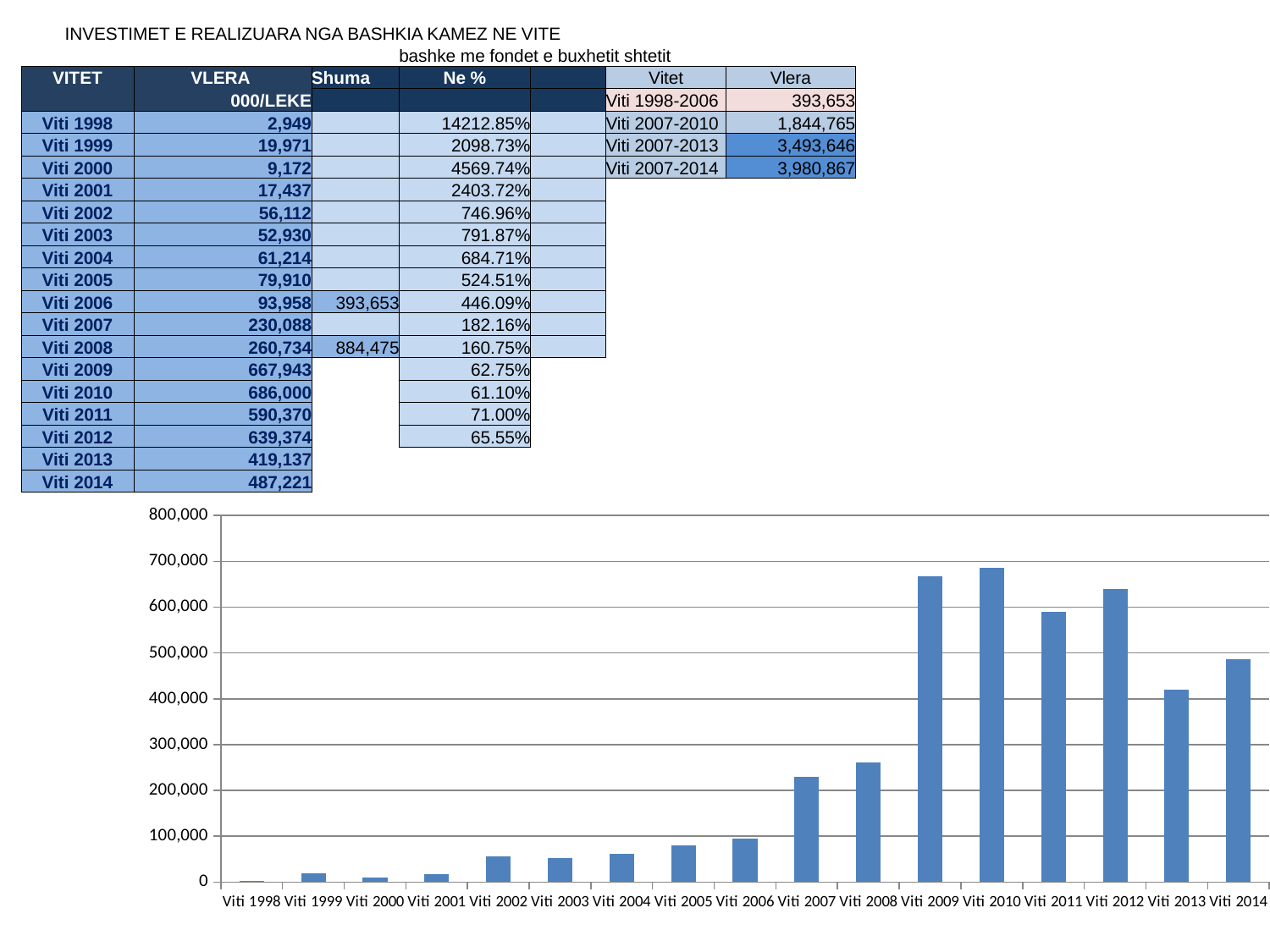
According to the table, what is the value (VLERA, 000/LEKE) for Viti 2010? 686,000 Is the value for Viti 2007 greater or less than 200,000? greater Which is larger, the bar for Viti 2014 or the bar for Viti 2013? Viti 2014 How many years (bars) are plotted in the chart? 17 Which year has the lowest bar in the chart? Viti 1998 Is the value for Viti 2009 greater or less than 600,000? greater What is the highest value shown on the chart's vertical axis? 800,000 According to the table, what is the value (VLERA, 000/LEKE) for Viti 2014? 487,221 Which is larger, the bar for Viti 2011 or the bar for Viti 2012? Viti 2012 What kind of chart is shown at the bottom of the slide? bar chart Which year has the highest bar in the chart? Viti 2010 Is the value for Viti 2013 greater or less than 500,000? less